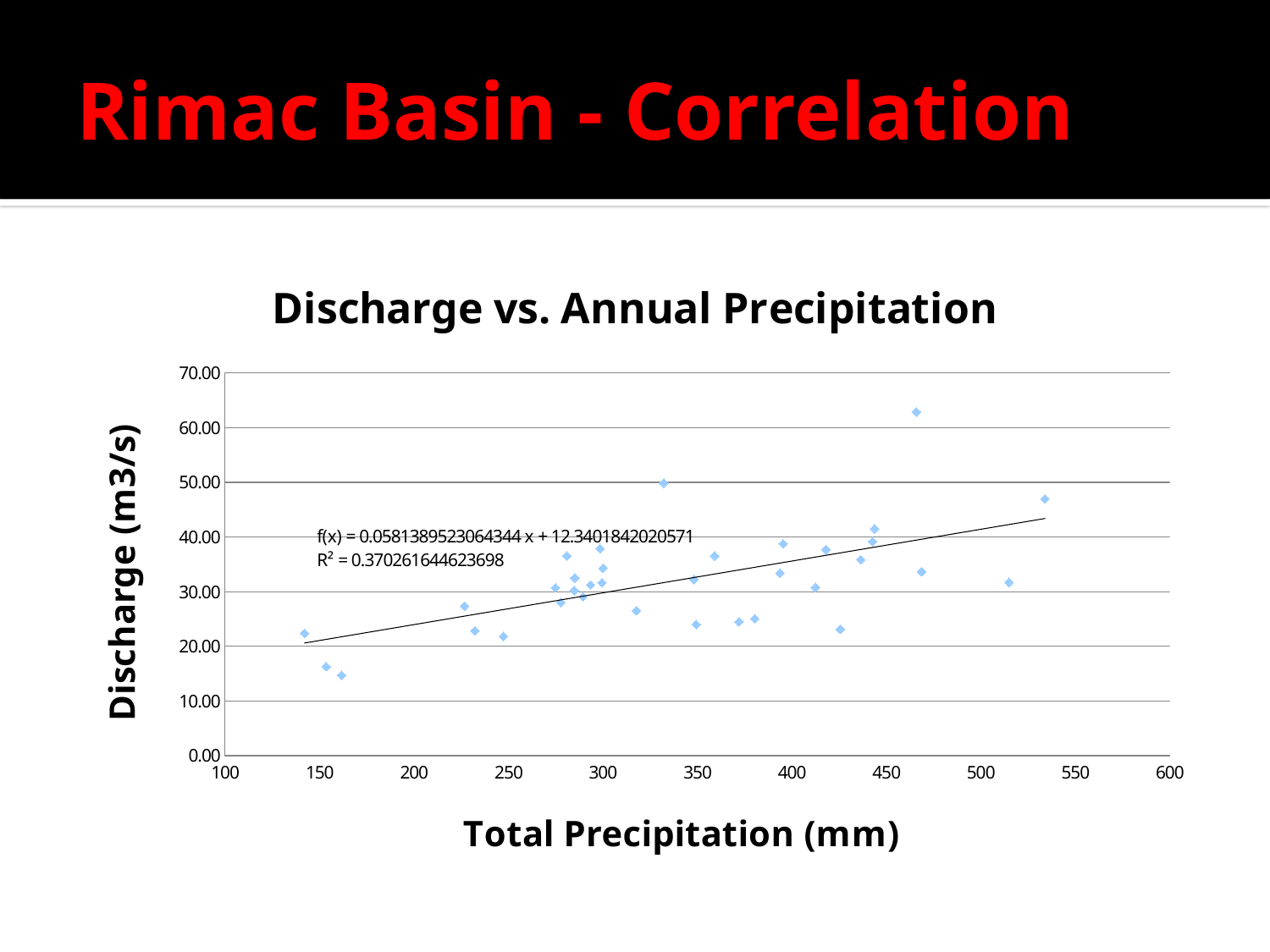
What is the title of the chart? Discharge vs. Annual Precipitation Is the total precipitation of the highest-discharge point greater or less than 400? greater What is the trendline equation printed on the chart? f(x) = 0.0581389523064344 x + 12.3401842020571 Is the discharge value of the lowest point on the chart greater or less than 20.00? less What is the minimum value shown on the x axis of the chart? 100 Is the discharge value of the highest point on the chart greater or less than 60.00? greater What R² value is printed on the chart? 0.370261644623698 What is the label of the x axis of the chart? Total Precipitation (mm) Is the slope of the trendline on the chart positive or negative? Positive What is the maximum value shown on the y axis of the chart? 70.00 What kind of chart is shown on the slide? Scatter chart Does discharge tend to rise or fall as total precipitation increases along the x axis? Rise